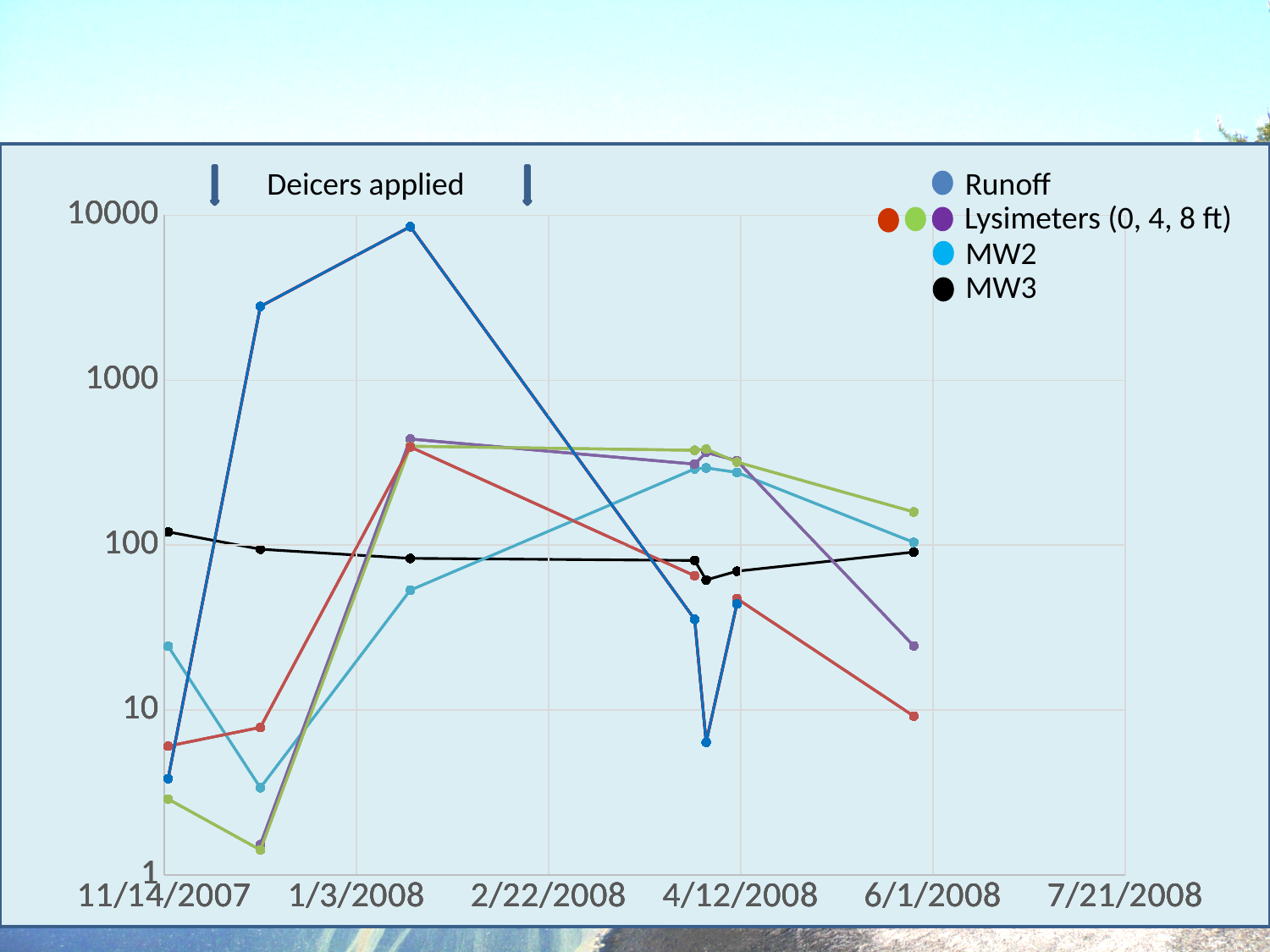
Is the value of the MW2 series at 11/14/2007 greater or less than 10? greater Is the value of the 8 ft lysimeter (purple) series at 6/1/2008 greater or less than 10? greater How many entries does the chart legend list? 4 Which series reaches the highest value on the chart? Runoff How many date labels are shown on the x axis? 6 What kind of chart is shown on the slide? line chart At 6/1/2008, which is larger: the 4 ft lysimeter (green) value or the 8 ft lysimeter (purple) value? 4 ft lysimeter (green) Is the value of the Runoff series at 11/14/2007 greater or less than 10? less Does the MW3 series rise or fall between 11/14/2007 and 1/3/2008? fall What text annotation appears between the two arrows at the top of the chart? Deicers applied